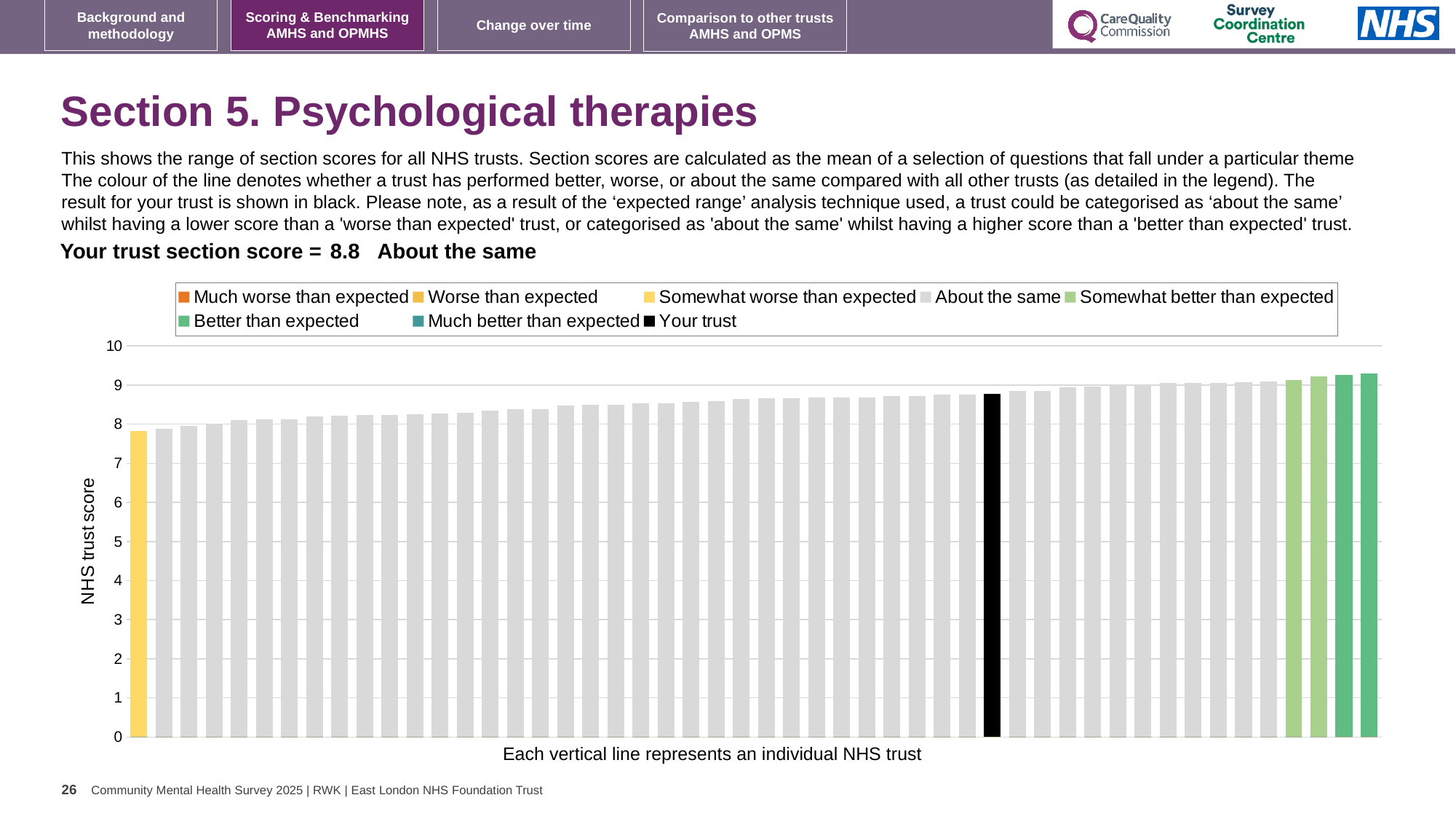
Is the value of the leftmost bar greater or less than 7? greater Is the value of the rightmost bar greater or less than 9? greater Do the bar values rise or fall from left to right along the x axis? rise Which category is your trust placed in according to the slide? About the same What is the label on the vertical axis of the chart? NHS trust score Is the value of the black 'Your trust' bar greater or less than 8? greater What kind of chart is shown on the slide? bar chart How many bars on the chart are coloured yellow (worse than expected)? 1 What is the section score for your trust shown on the slide? 8.8 How many entries does the chart legend list? 8